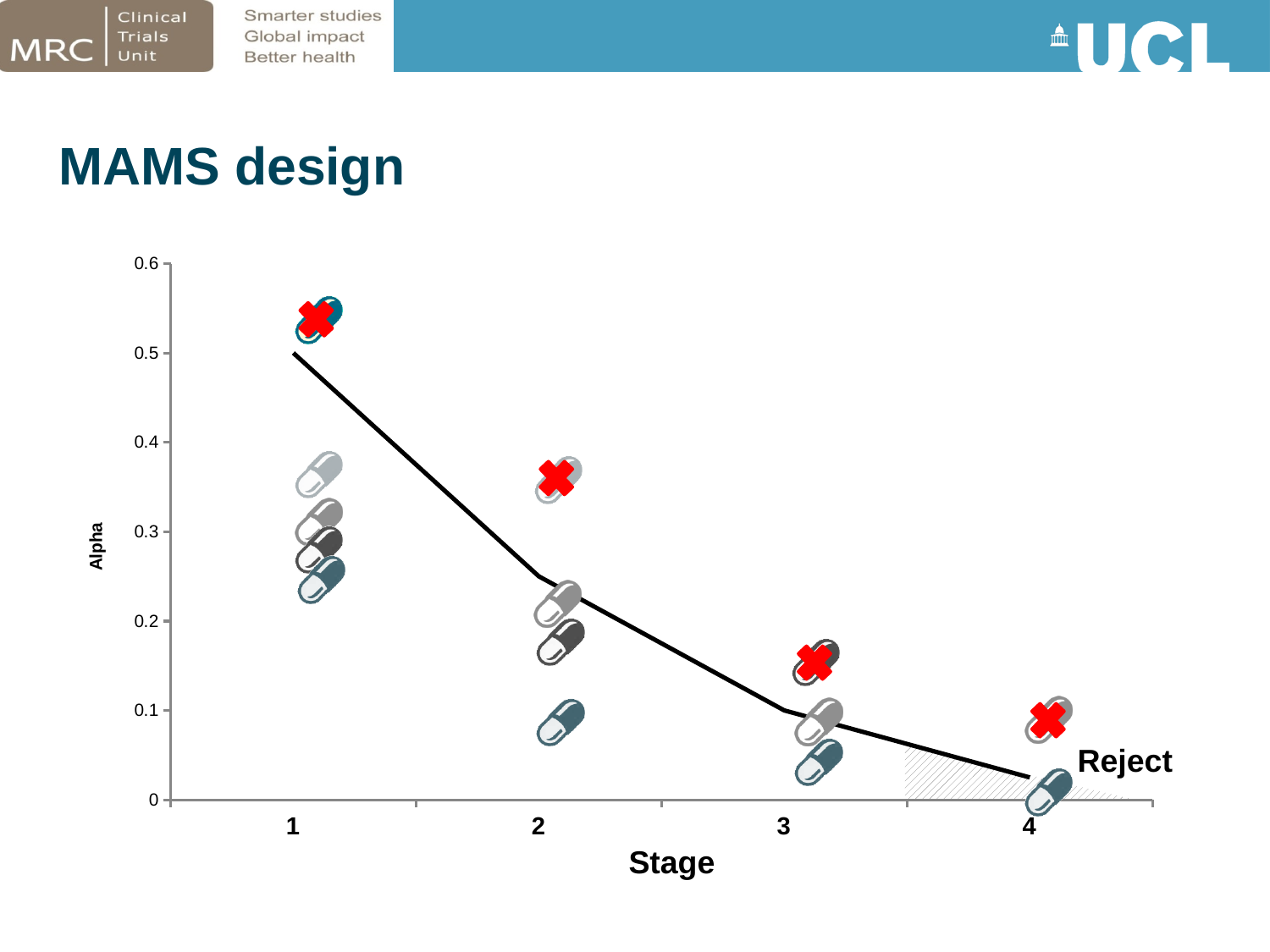
Does the black line rise or fall as the stage increases from 1 to 4? fall Is the value of the black line at stage 2 greater or less than 0.3? less What is the label of the y axis? Alpha What is the title of the slide containing the chart? MAMS design Is the value of the black line at stage 4 greater or less than 0.1? less Is the value of the black line at stage 1 greater or less than 0.4? greater At which stage is the black line lowest? 4 How many stages are marked along the x axis? 4 What kind of chart is shown on the slide? line chart Which is larger, the value of the black line at stage 2 or at stage 3? stage 2 At which stage is the black line highest? 1